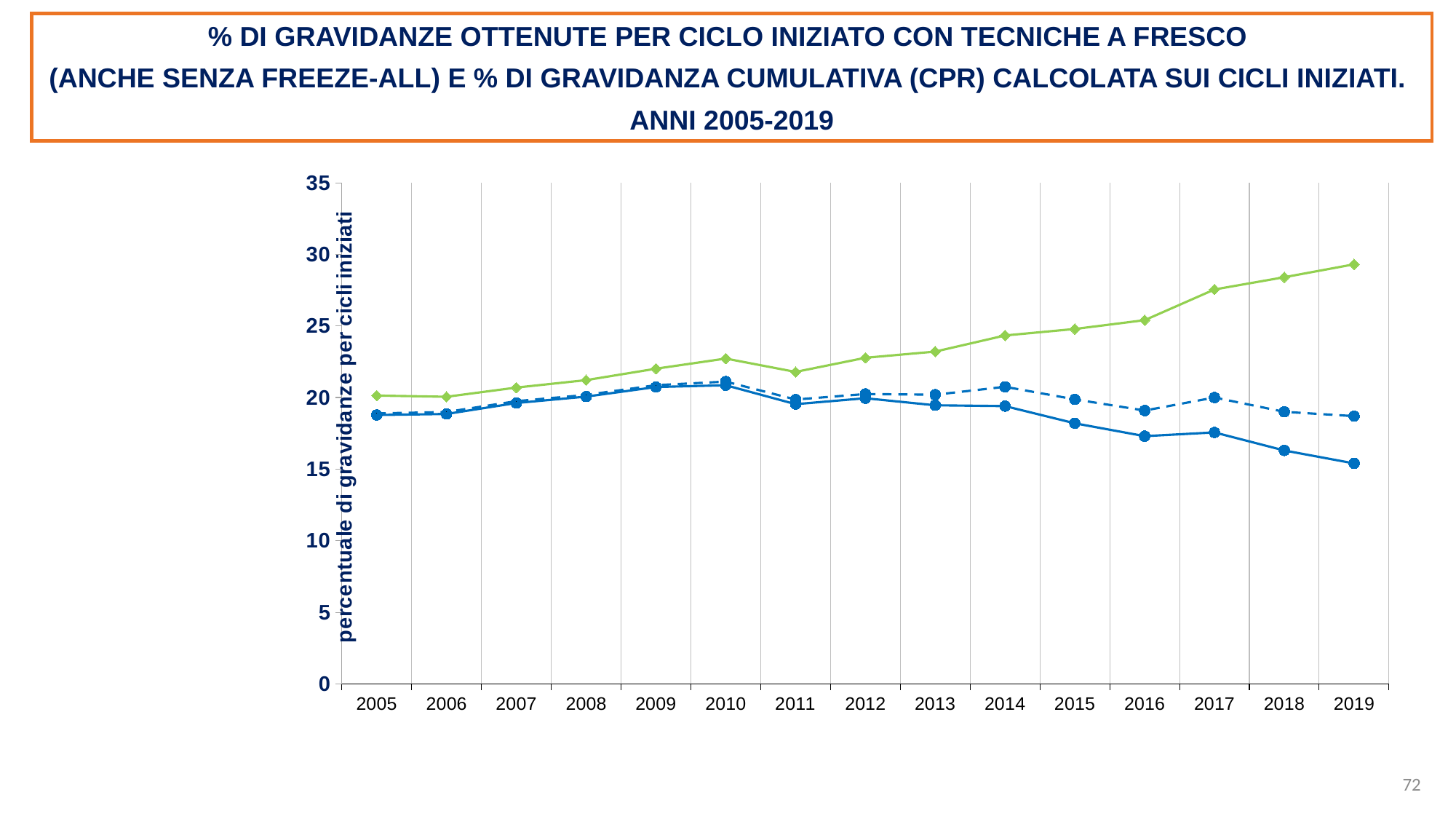
How many years are plotted along the x axis? 15 Is the value of the green line in 2019 greater or less than 25? greater In which year does the solid blue line reach its lowest value? 2019 What is the label on the y axis? percentuale di gravidanze per cicli iniziati Is the value of the dashed blue line in 2014 greater or less than 25? less Is the value of the solid blue line in 2019 greater or less than 20? less In which year does the green line reach its highest value? 2019 In 2019, which line has the higher value, the green line or the solid blue line? the green line How many lines are plotted on the chart? 3 Does the green line rise or fall from 2011 to 2019? rise What kind of chart is shown on the slide? line chart